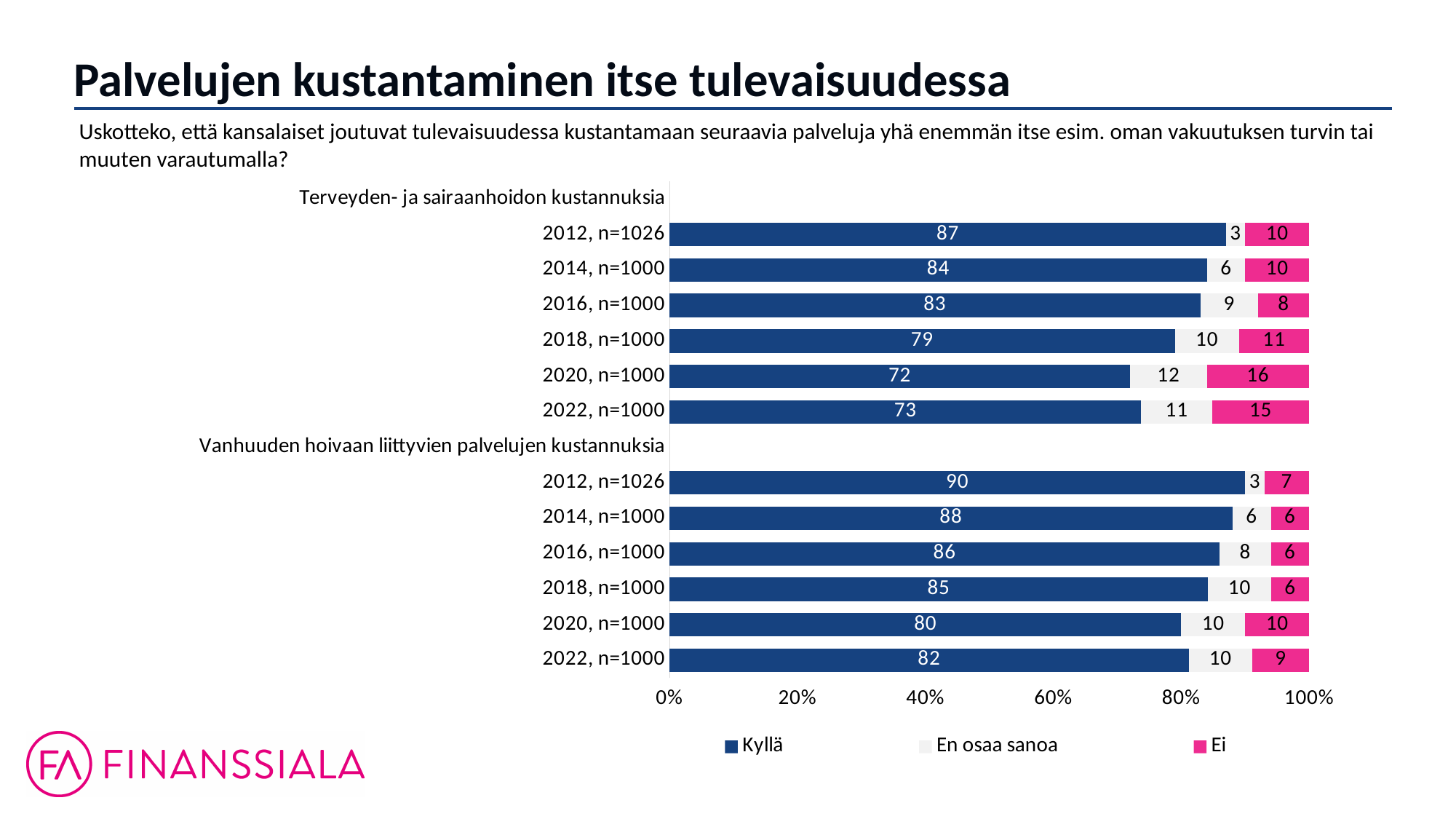
What is the total of the stacked bar for 'Vanhuuden hoivaan liittyvien palvelujen kustannuksia' in 2014, n=1000? 100 How does the Kyllä value for 'Terveyden- ja sairaanhoidon kustannuksia' change from 2012 to 2020? It falls Which colour represents the Ei series in the chart? Pink What kind of chart is shown on the slide? Stacked bar chart Which is larger: the Kyllä value for 'Terveyden- ja sairaanhoidon kustannuksia' in 2022, n=1000 or for 'Vanhuuden hoivaan liittyvien palvelujen kustannuksia' in 2022, n=1000? Vanhuuden hoivaan liittyvien palvelujen kustannuksia Which year has the highest Kyllä value for 'Vanhuuden hoivaan liittyvien palvelujen kustannuksia'? 2012, n=1026 What is the difference between the Kyllä values for 'Terveyden- ja sairaanhoidon kustannuksia' in 2012, n=1026 and 2022, n=1000? 14 What is the En osaa sanoa value for 'Vanhuuden hoivaan liittyvien palvelujen kustannuksia' in 2018, n=1000? 10 Which year has the lowest Kyllä value for 'Terveyden- ja sairaanhoidon kustannuksia'? 2020, n=1000 What is the Kyllä value for 'Terveyden- ja sairaanhoidon kustannuksia' in 2012, n=1026? 87 What is the Ei value for 'Terveyden- ja sairaanhoidon kustannuksia' in 2020, n=1000? 16 How many series does the legend list? 3